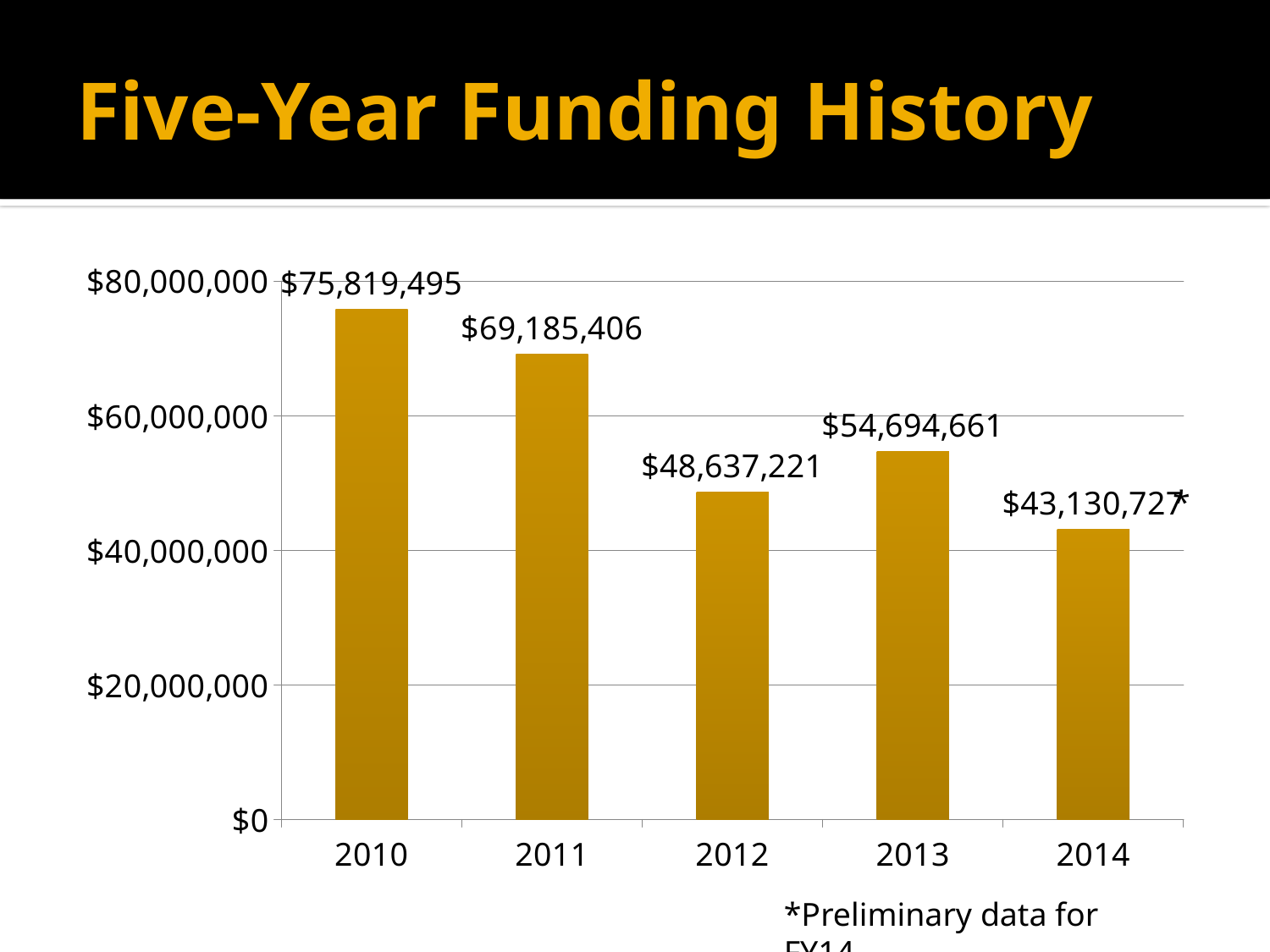
Does funding rise or fall from 2010 to 2012? fall What is the difference in funding between 2013 and 2012? $6,057,440 What is the funding value for 2013? $54,694,661 Which year has the lowest funding? 2014 Which year has higher funding, 2012 or 2013? 2013 What kind of chart is shown on the slide? bar chart Which year has the highest funding? 2010 What is the funding value for 2014? $43,130,727 What is the difference in funding between 2010 and 2011? $6,634,089 What is the funding value for 2010? $75,819,495 How many years are shown on the chart? 5 Is the funding value for 2011 greater or less than $60,000,000? greater